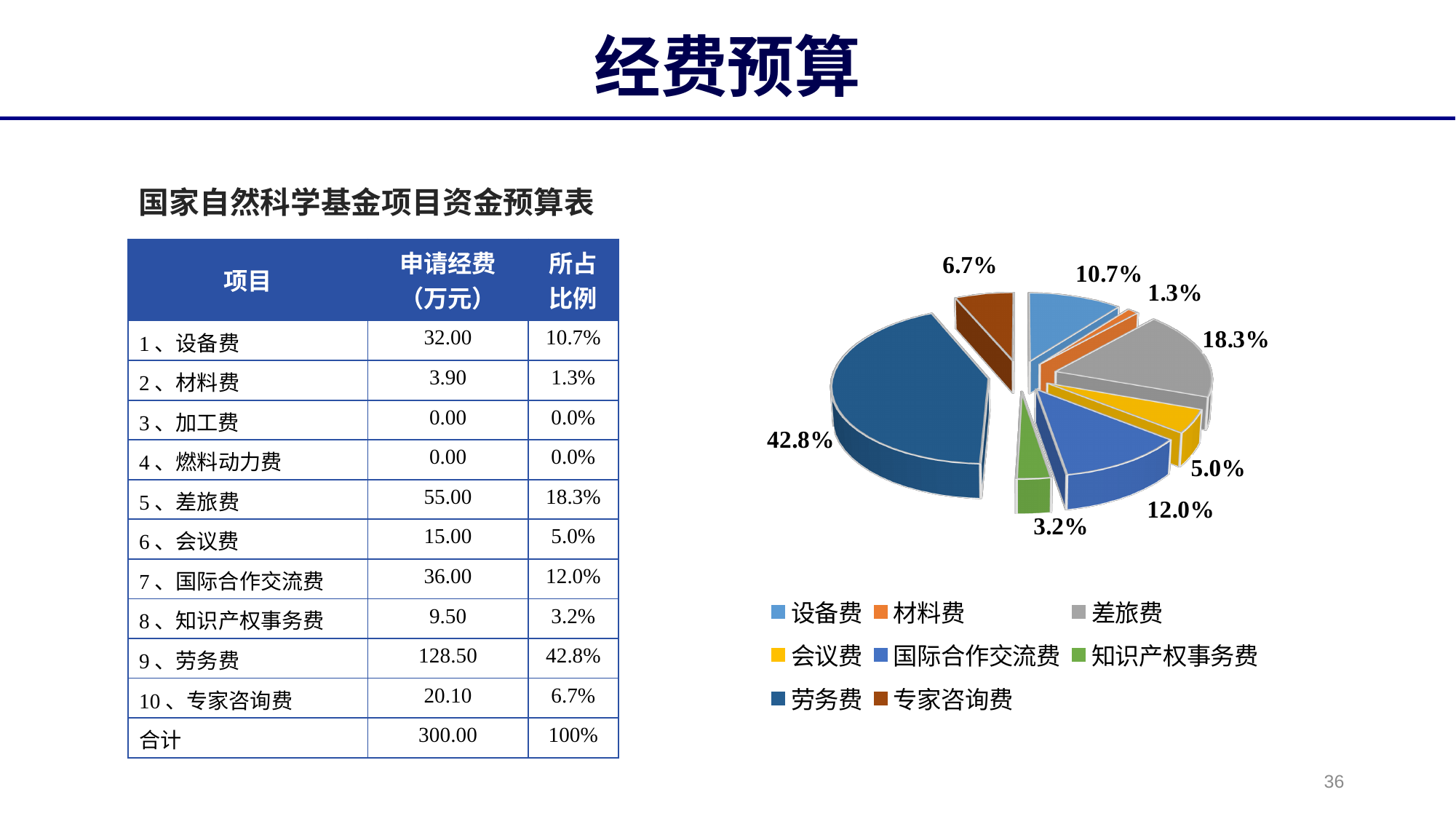
What share of the pie does 专家咨询费 take? 6.7% What share of the pie does 差旅费 take? 18.3% Which category has the smallest slice of the pie? 材料费 Which category has the largest slice of the pie? 劳务费 What kind of chart is shown on the slide? pie chart What is the difference in percentage points between the share for 差旅费 and the share for 设备费? 7.6% What share of the pie does 设备费 take? 10.7% How many slices does the pie chart have? 8 Which is larger, the share for 国际合作交流费 or the share for 会议费? 国际合作交流费 How many entries does the legend list? 8 What colour is the slice for 知识产权事务费? green